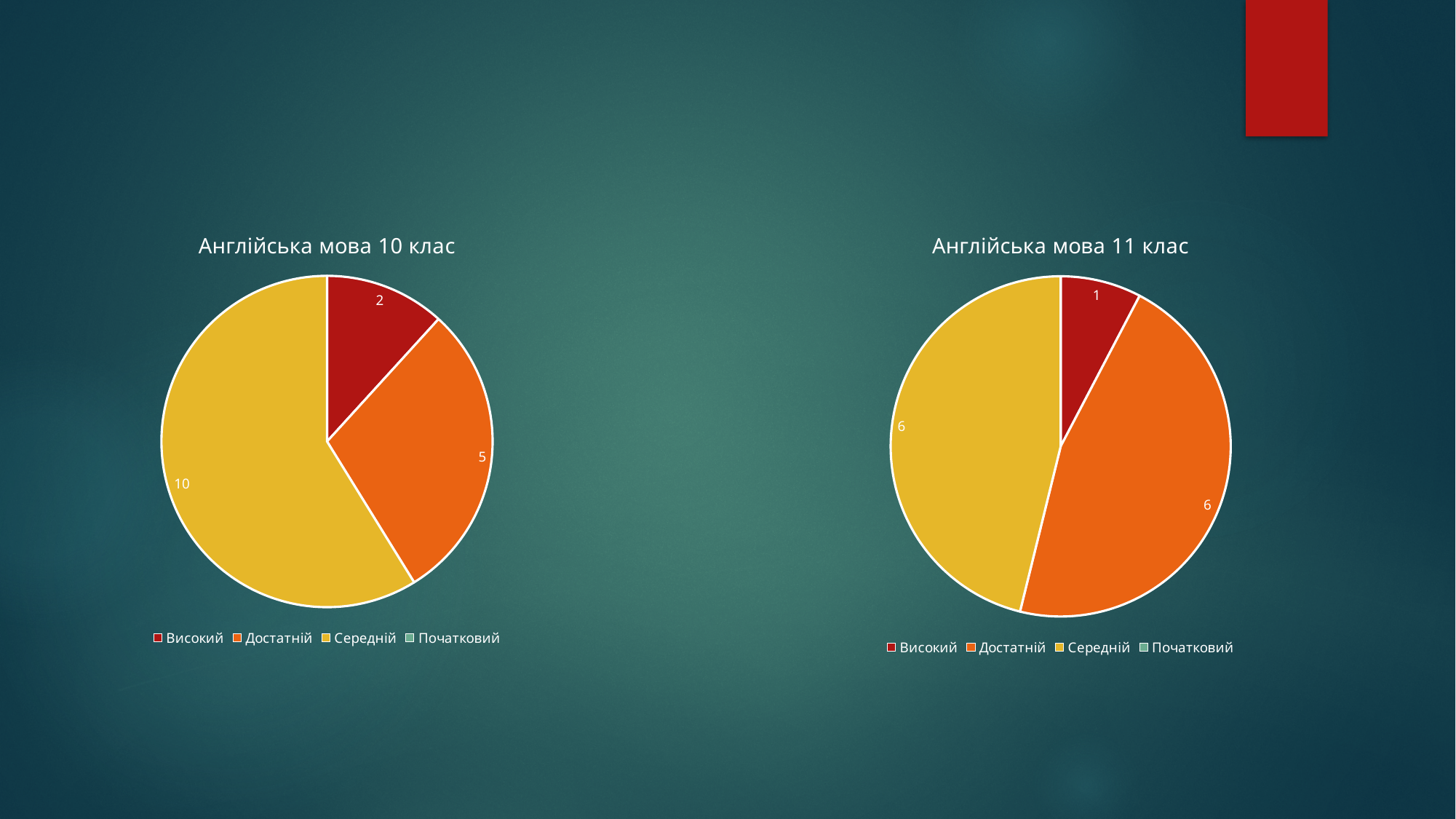
In the chart titled "Англійська мова 11 клас", what is the difference between the values for Середній and Високий? 5 In the chart titled "Англійська мова 10 клас", what is the difference between the values for Середній and Достатній? 5 In the chart titled "Англійська мова 10 клас", which category has the largest slice? Середній In the chart titled "Англійська мова 11 клас", what is the value for Достатній? 6 What is the title of the chart on the right side of the slide? Англійська мова 11 клас In the chart titled "Англійська мова 10 клас", which is larger, the value for Достатній or the value for Високий? Достатній In the chart titled "Англійська мова 10 клас", what is the value for Середній? 10 What kind of chart is "Англійська мова 11 клас"? Pie chart In the chart titled "Англійська мова 11 клас", which labelled category has the smallest slice? Високий How many entries does the legend of the chart titled "Англійська мова 10 клас" list? 4 In the chart titled "Англійська мова 11 клас", what is the value for Високий? 1 In the chart titled "Англійська мова 10 клас", what is the value for Високий? 2